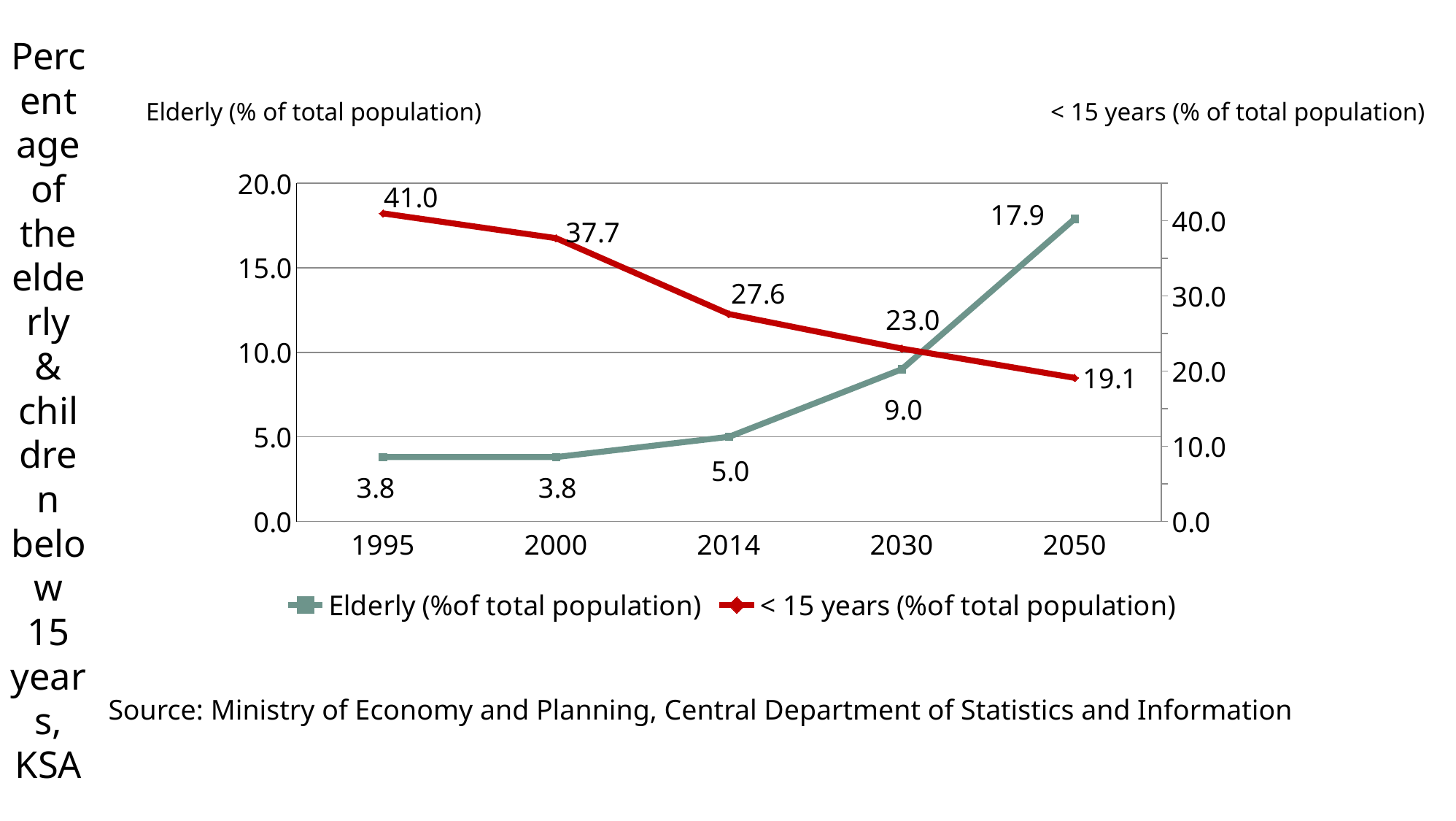
How many series does the legend list? 2 What is the < 15 years (% of total population) value for 2030? 23.0 What is the Elderly (% of total population) value for 2014? 5.0 In which year is the Elderly (% of total population) value highest? 2050 In which year is the < 15 years (% of total population) value lowest? 2050 What kind of chart is shown on the slide? Line chart What is the difference between the < 15 years values for 1995 and 2050? 21.9 What is the Elderly (% of total population) value for 2050? 17.9 How many years are shown on the x axis? 5 Which is larger: the < 15 years value for 2000 or for 2014? 2000 What is the < 15 years (% of total population) value for 1995? 41.0 What is the difference between the Elderly values for 2030 and 2050? 8.9